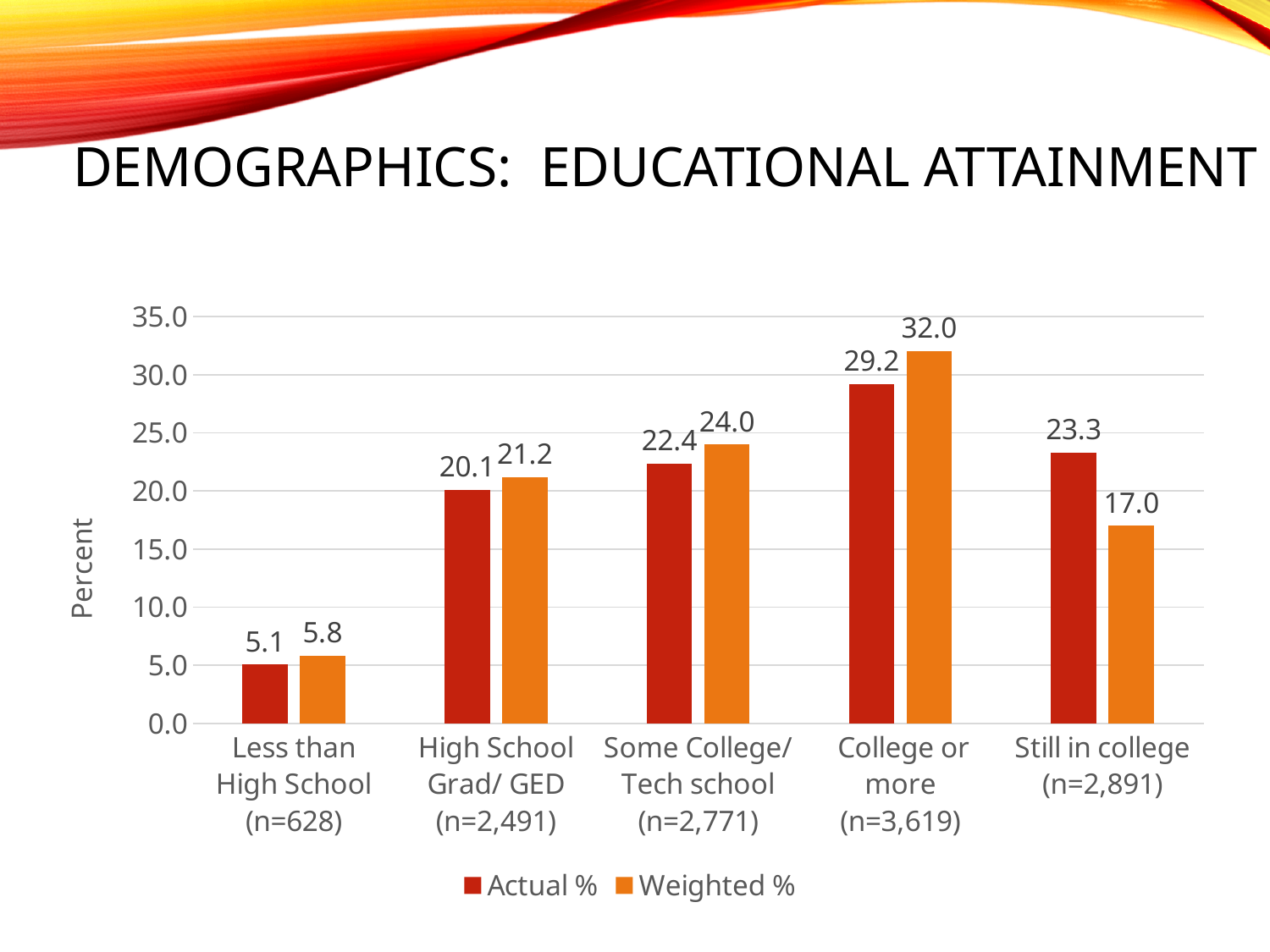
How many categories are shown on the x axis? 5 Which category has the lowest Actual % value? Less than High School (n=628) What is the label of the y axis? Percent What is the Weighted % value for Still in college (n=2,891)? 17.0 What is the Actual % value for College or more (n=3,619)? 29.2 Which category has the highest Weighted % value? College or more (n=3,619) What kind of chart is shown on the slide? bar chart Which is larger for High School Grad/ GED (n=2,491): the Actual % or the Weighted % value? Weighted % What is the Weighted % value for Less than High School (n=628)? 5.8 How many series does the legend list? 2 Is the Actual % value for Some College/ Tech school (n=2,771) greater or less than 20.0? greater What is the difference between the Weighted % and Actual % values for Still in college (n=2,891)? 6.3